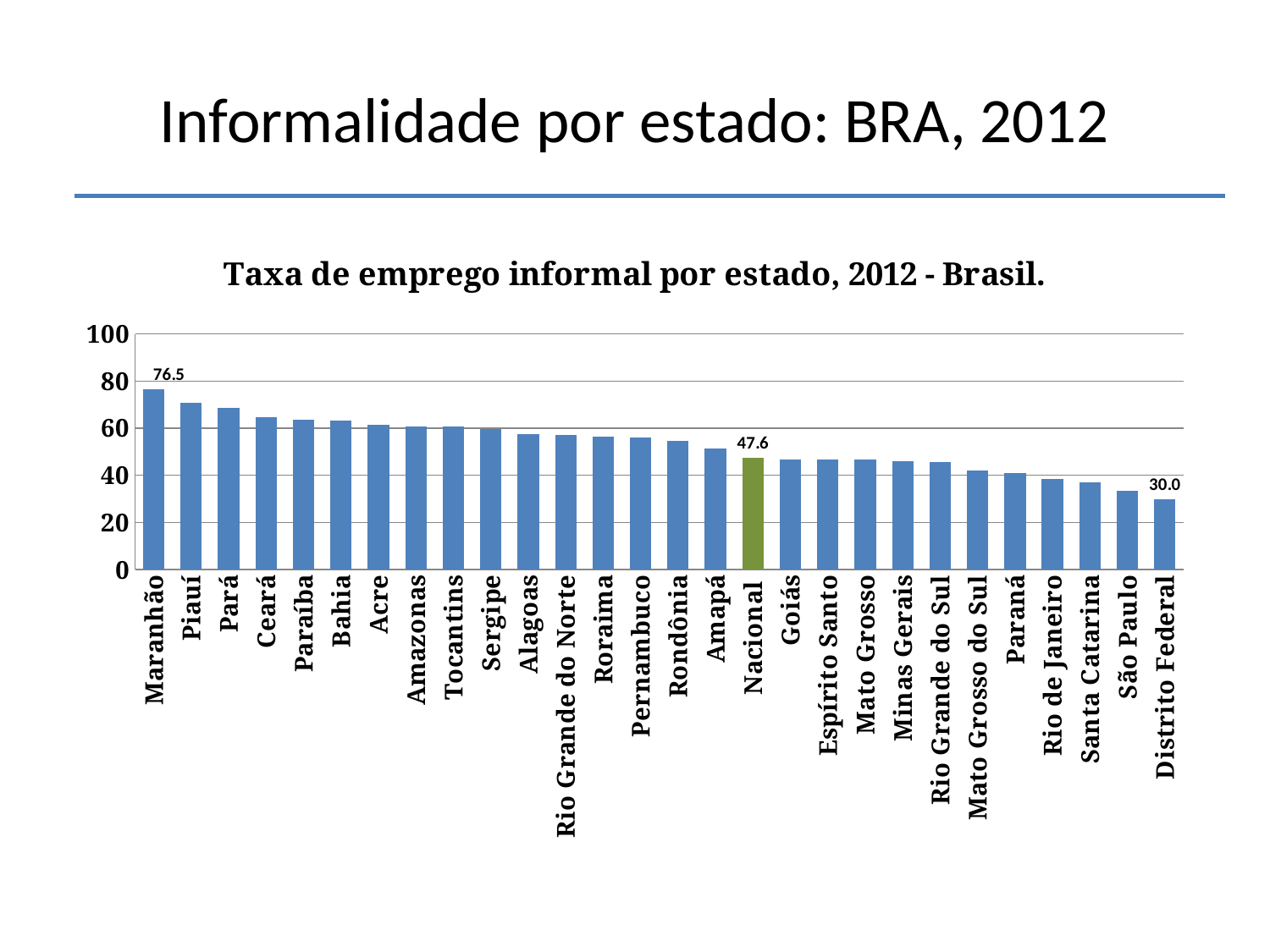
What is the difference between the values for Maranhão and Distrito Federal? 46.5 What is the value for Maranhão? 76.5 How many bars are shown in the chart? 28 What kind of chart is shown on the slide? Bar chart Is the value for São Paulo greater or less than 40? less Which state has the highest informal employment rate? Maranhão Is the value for Piauí greater or less than 60? greater What is the value for Nacional? 47.6 Which category has the lowest value? Distrito Federal What is the difference between the values for Maranhão and Nacional? 28.9 Which is larger, the value for Ceará or the value for Goiás? Ceará What is the value for Distrito Federal? 30.0